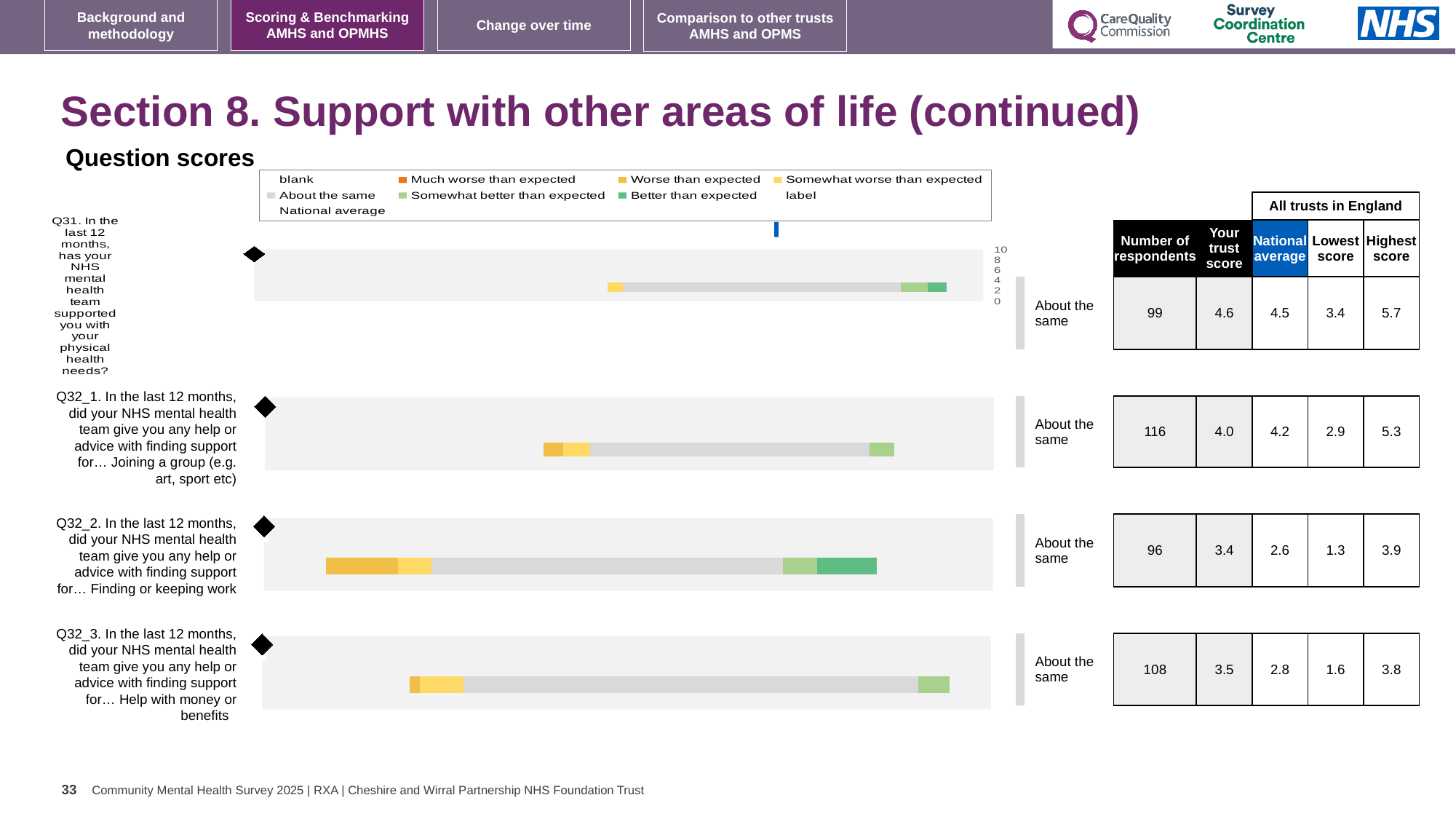
Which question has the highest number of respondents? Q32_1 (Joining a group) What is the difference between the trust score and the national average for Q32_2 (finding or keeping work)? 0.8 How many questions (bars) are plotted in the question scores charts? 4 How many respondents answered Q32_2 (help with finding or keeping work)? 96 Which question has the lowest 'Your trust score'? Q32_2 (Finding or keeping work) What benchmark category is shown next to the bar for Q31? About the same What is the title shown above the charts? Question scores What is the national average score for Q32_1 (help with joining a group)? 4.2 What is the highest score among all trusts in England for Q32_3 (help with money or benefits)? 3.8 For Q32_2 (finding or keeping work), which is larger: the trust score or the national average? Trust score What is the 'Your trust score' for Q31 (support with physical health needs)? 4.6 What kind of chart is used to show the question scores on this slide? Bar chart